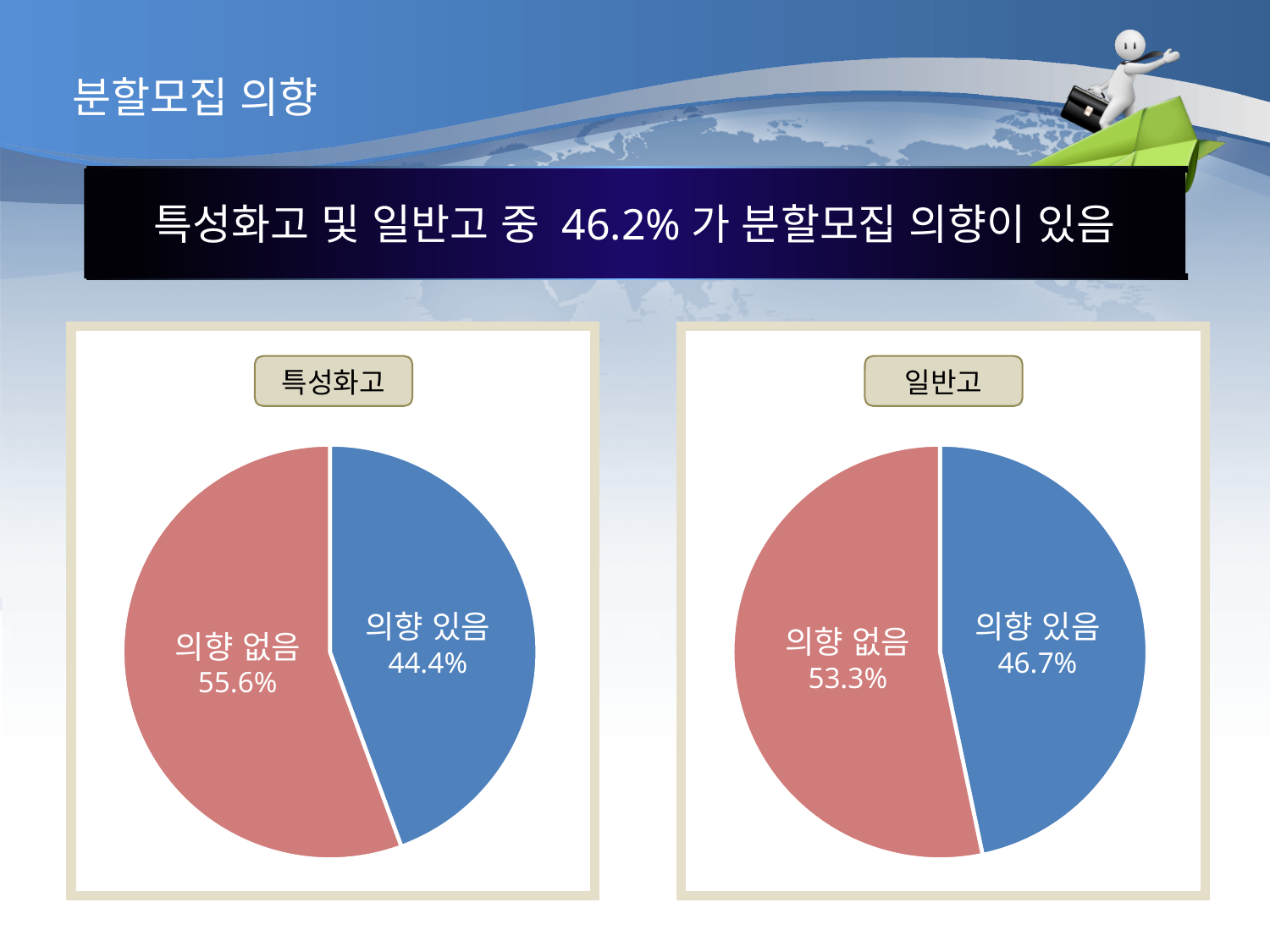
In the 일반고 pie chart, what is the value for 의향 있음? 46.7% In the 특성화고 pie chart, which slice is the largest? 의향 없음 What colour is the 의향 있음 slice in the 특성화고 pie chart? Blue In the 특성화고 pie chart, what is the value for 의향 있음? 44.4% What kind of chart is used for 일반고? Pie chart In the 일반고 pie chart, what is the difference between 의향 없음 and 의향 있음? 6.6% In the 일반고 pie chart, which slice is the smallest? 의향 있음 How many slices does the 특성화고 pie chart have? 2 In the 특성화고 pie chart, what is the difference between 의향 없음 and 의향 있음? 11.2% In the 특성화고 pie chart, what is the value for 의향 없음? 55.6% Which chart shows a larger value for 의향 있음, 특성화고 or 일반고? 일반고 In the 일반고 pie chart, what is the value for 의향 없음? 53.3%